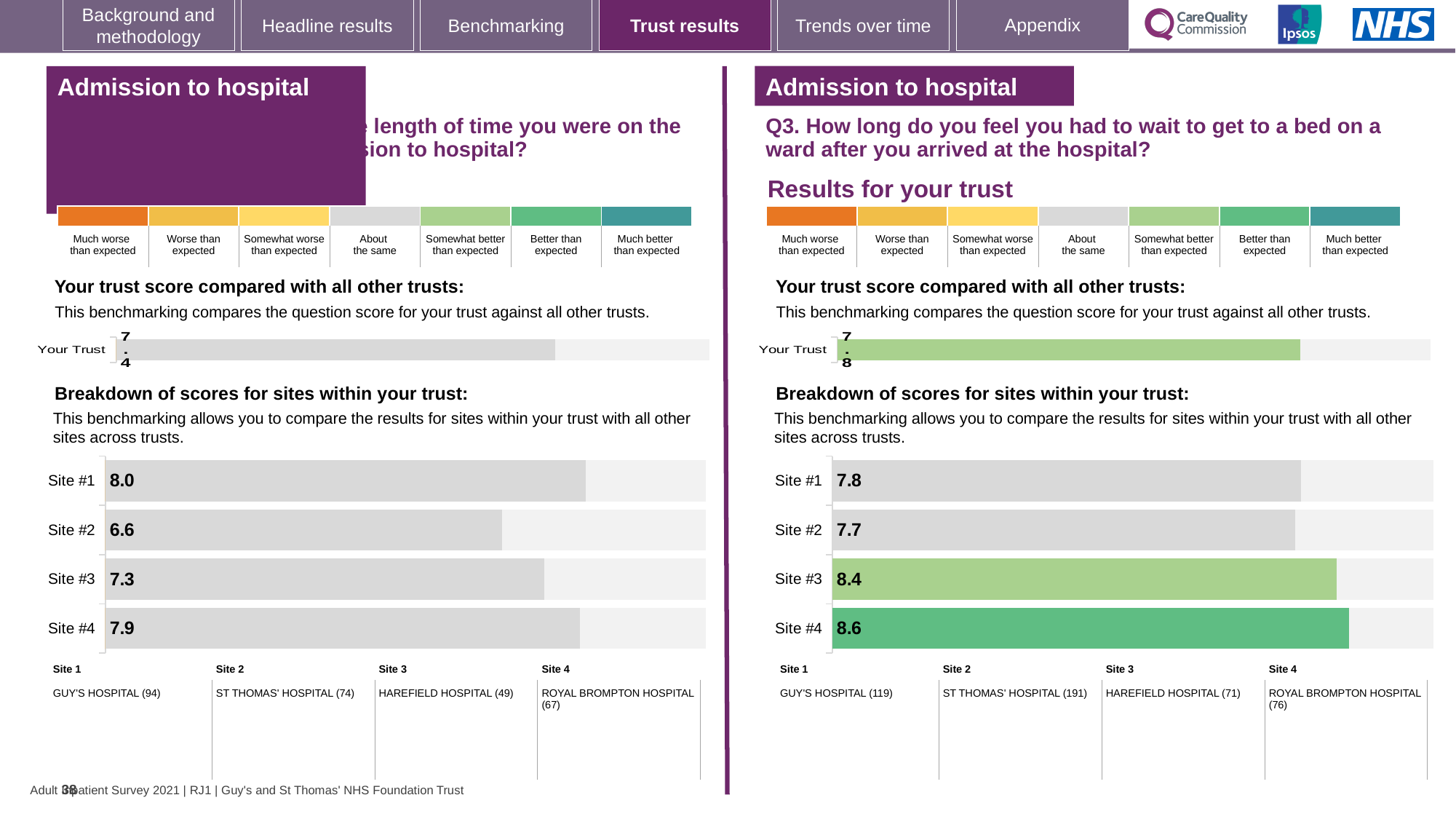
In the right-hand (Q3) 'Breakdown of scores for sites within your trust' chart, what is the score for Site #4? 8.6 In the right-hand (Q3) site breakdown chart, which site has the lowest score? Site #2 In the right-hand (Q3) site breakdown chart, which has the larger score, Site #3 or Site #1? Site #3 In the right-hand (Q3) site breakdown chart, which site has the highest score? Site #4 In the right-hand (Q3) 'Your trust score compared with all other trusts' chart, what is the score for Your Trust? 7.8 In the left-hand 'Breakdown of scores for sites within your trust' chart, what is the score for Site #2? 6.6 In the left-hand site breakdown chart, which site has the lowest score? Site #2 How many sites are shown in the left-hand site breakdown chart? 4 In the right-hand (Q3) site breakdown chart, what is the difference between the scores for Site #4 and Site #1? 0.8 In the left-hand site breakdown chart, which site has the highest score? Site #1 What type of chart is used for the 'Breakdown of scores for sites within your trust' on the right-hand side? Bar chart In the left-hand site breakdown chart, what is the difference between the scores for Site #1 and Site #2? 1.4